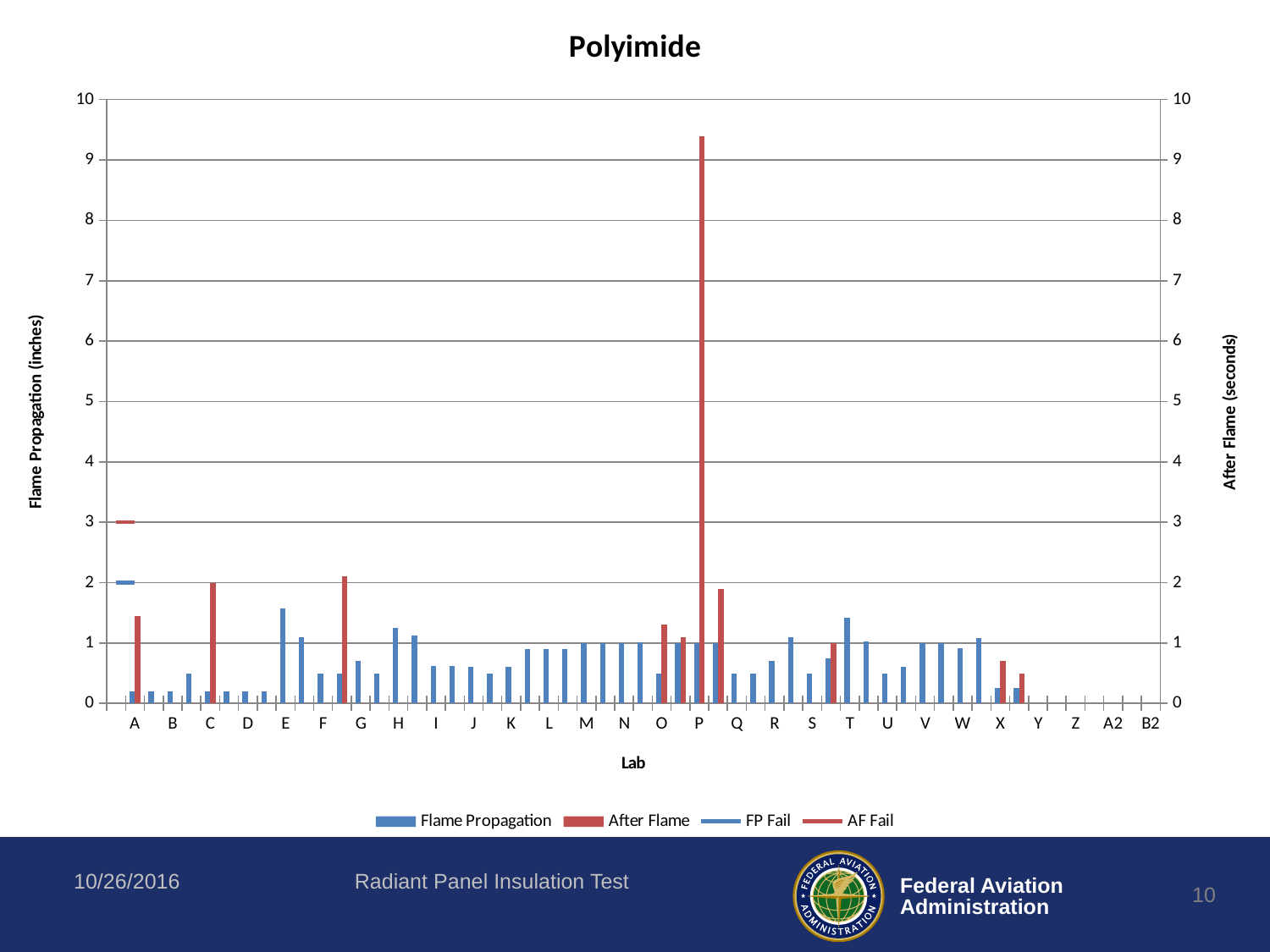
Is the After Flame value for lab C greater or less than 1? greater How many labs are shown along the x axis? 28 What is the title of the chart? Polyimide What type of chart is shown on the slide? bar chart Which lab has the highest Flame Propagation value? E Is the Flame Propagation value for lab E greater or less than 1? greater What is the title of the x axis? Lab Is the Flame Propagation value for lab B greater or less than 1? less Which lab has the highest After Flame value? P Which lab has the larger After Flame value, P or C? P How many entries does the chart legend list? 4